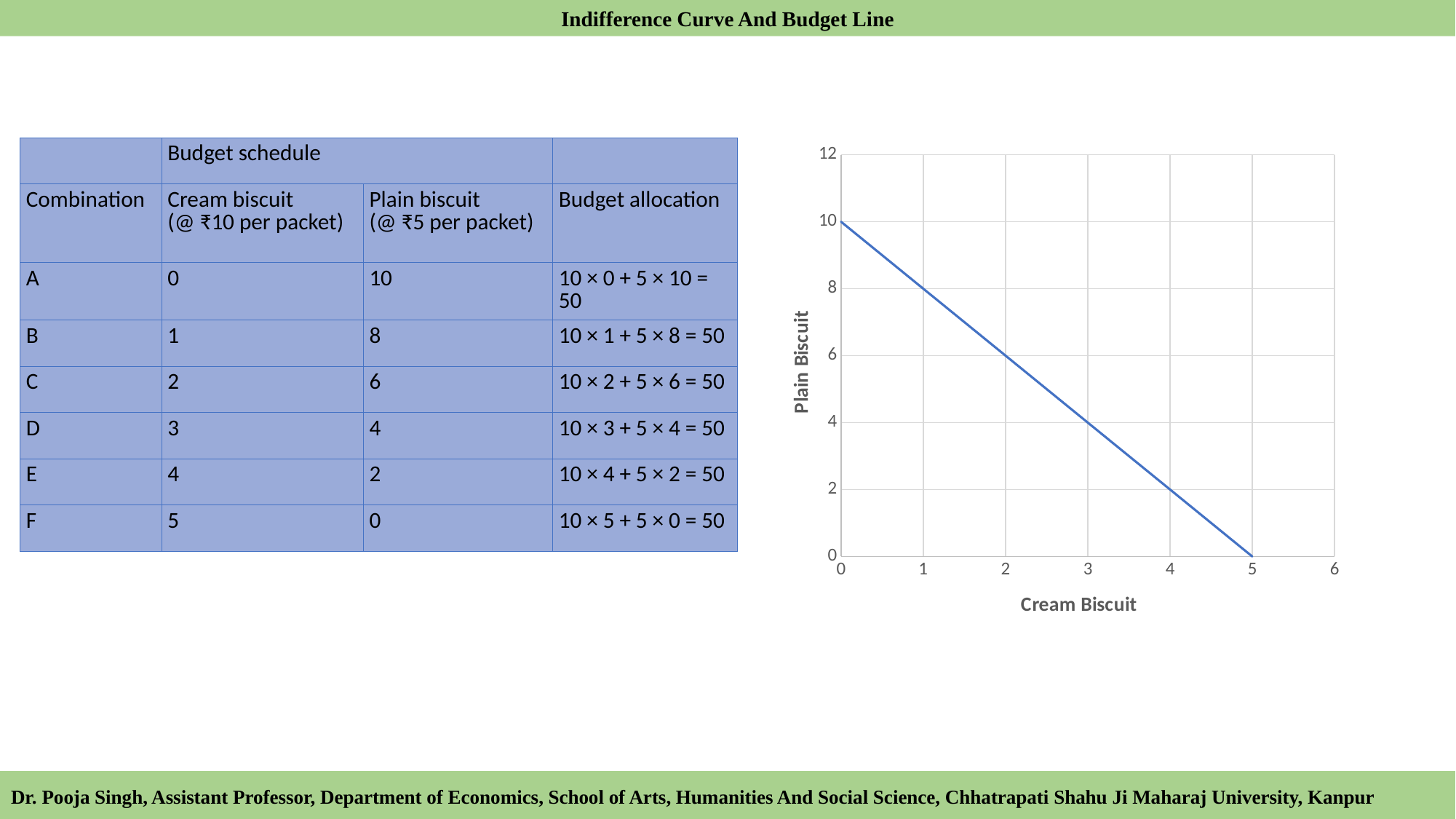
On the chart, at what value of Cream Biscuit does the line reach 0 on the Plain Biscuit axis? 5 Does the line on the chart rise or fall as Cream Biscuit increases? fall What is the label of the x axis of the chart? Cream Biscuit What kind of chart is shown on the slide? line chart What is the highest value shown on the y axis of the chart? 12 On the chart, what is the value of Plain Biscuit when Cream Biscuit is 2? 6 On the chart, which has the higher Plain Biscuit value: Cream Biscuit = 1 or Cream Biscuit = 4? Cream Biscuit = 1 On the chart, is the value of Plain Biscuit at Cream Biscuit = 4 greater or less than 4? less On the chart, what is the value of Plain Biscuit when Cream Biscuit is 3? 4 On the chart, what is the value of Plain Biscuit when Cream Biscuit is 0? 10 On the chart, is the value of Plain Biscuit at Cream Biscuit = 1 greater or less than 6? greater What is the label of the y axis of the chart? Plain Biscuit